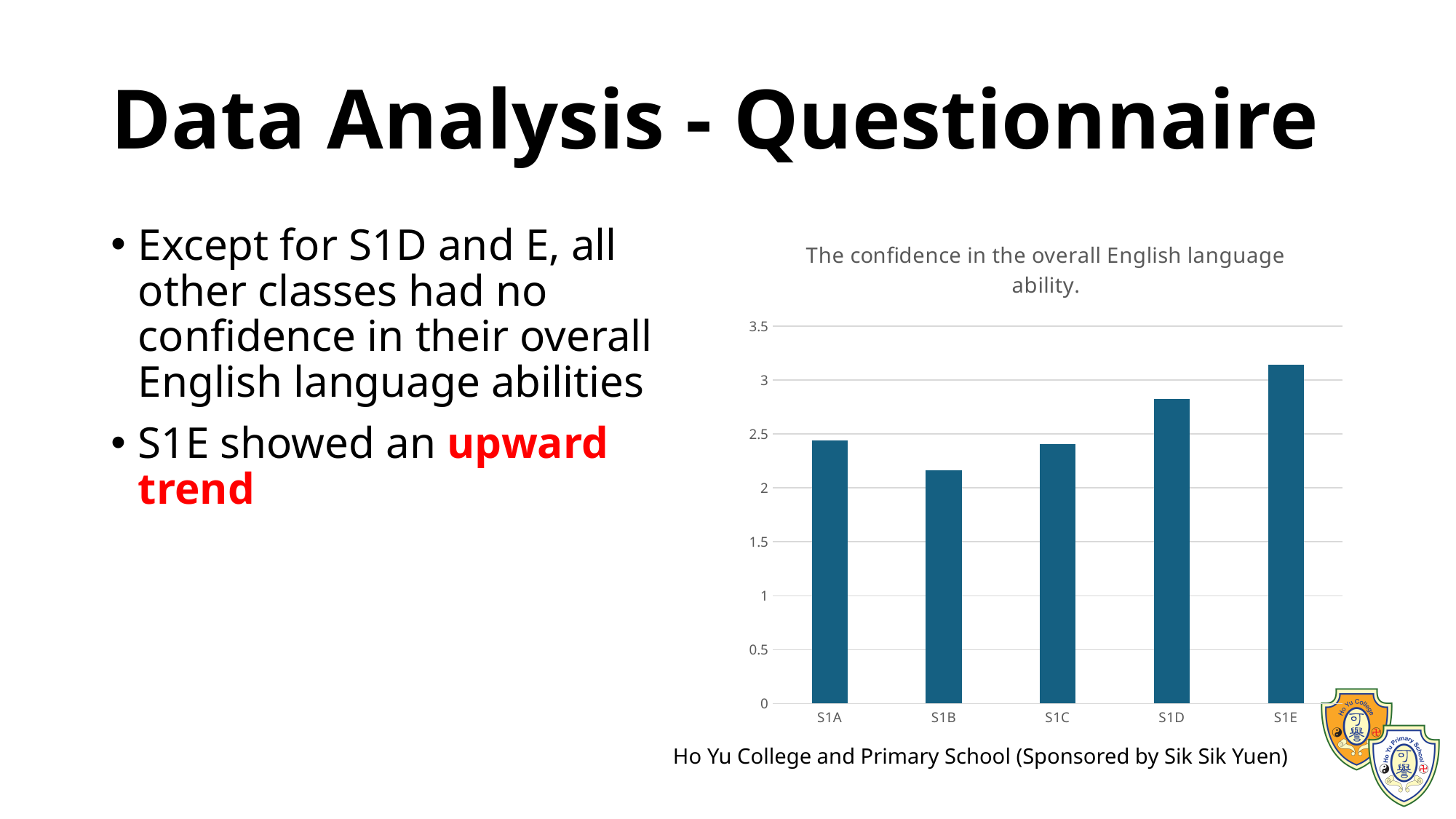
Which class has the lowest confidence value in the chart? S1B Is the value for S1D greater or less than 2.5? greater What is the title of the chart? The confidence in the overall English language ability. Is the value for S1E greater or less than 3? greater What is the highest value labelled on the vertical axis of the chart? 3.5 How many classes are shown on the x axis of the chart? 5 Is the value for S1B greater or less than 2.5? less Which class has the highest confidence value in the chart? S1E What kind of chart is shown on the slide? bar chart Which is larger, the value for S1D or the value for S1A? S1D Which is larger, the value for S1B or the value for S1E? S1E